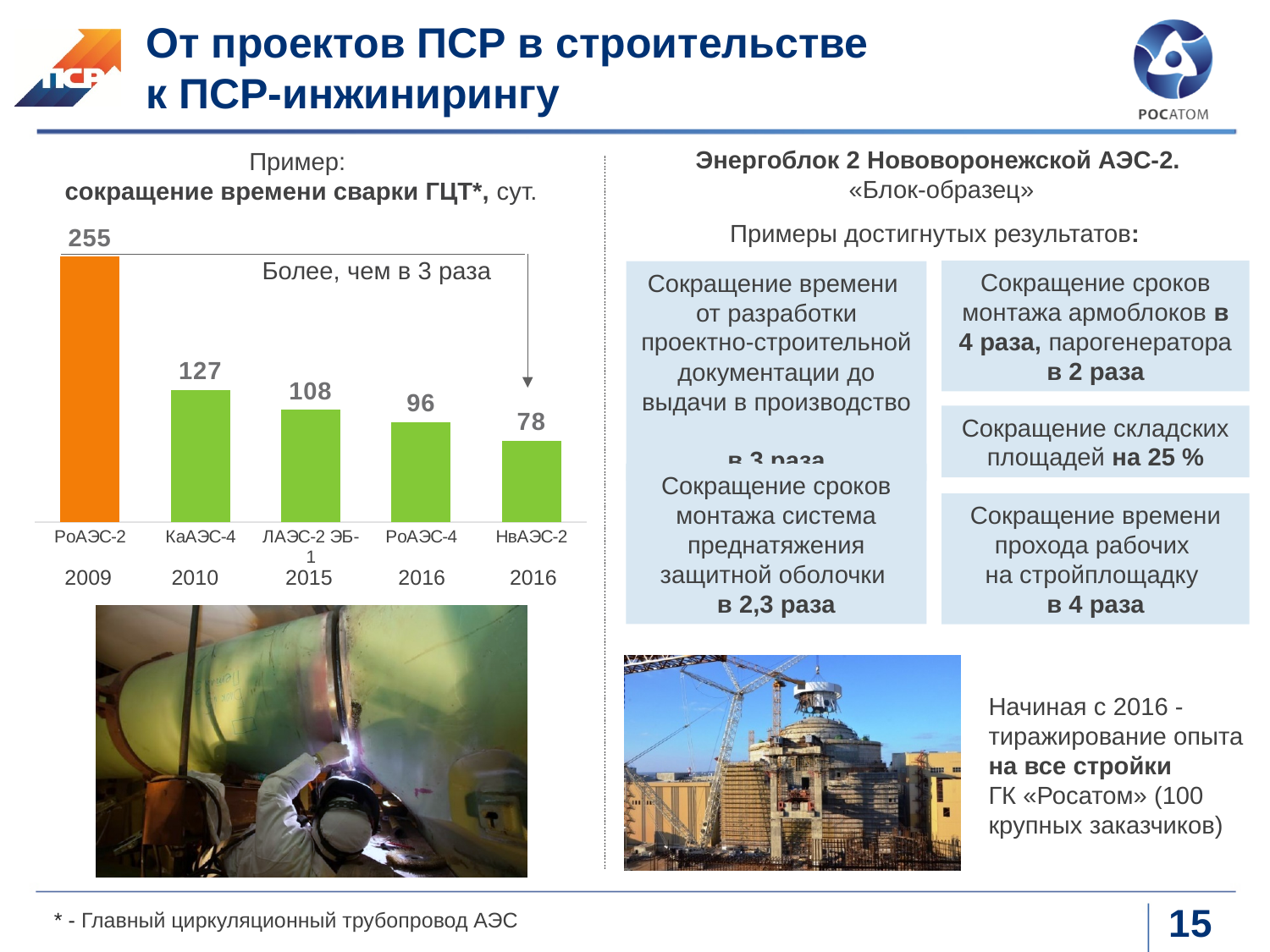
What is the difference between the values for РоАЭС-2 and НвАЭС-2? 177 Which is larger, the value for ЛАЭС-2 ЭБ-1 or the value for РоАЭС-4? ЛАЭС-2 ЭБ-1 What is the value for КаАЭС-4 in the chart? 127 What is the difference between the values for КаАЭС-4 and РоАЭС-4? 31 What is the value for НвАЭС-2 in the chart? 78 Which category has the lowest value in the chart? НвАЭС-2 How many bars are shown in the chart? 5 Do the values in the chart rise or fall from left to right? Fall What is the value for РоАЭС-2 in the chart? 255 What is the value for ЛАЭС-2 ЭБ-1 in the chart? 108 What type of chart is shown on the slide? Bar chart Which category has the highest value in the chart? РоАЭС-2